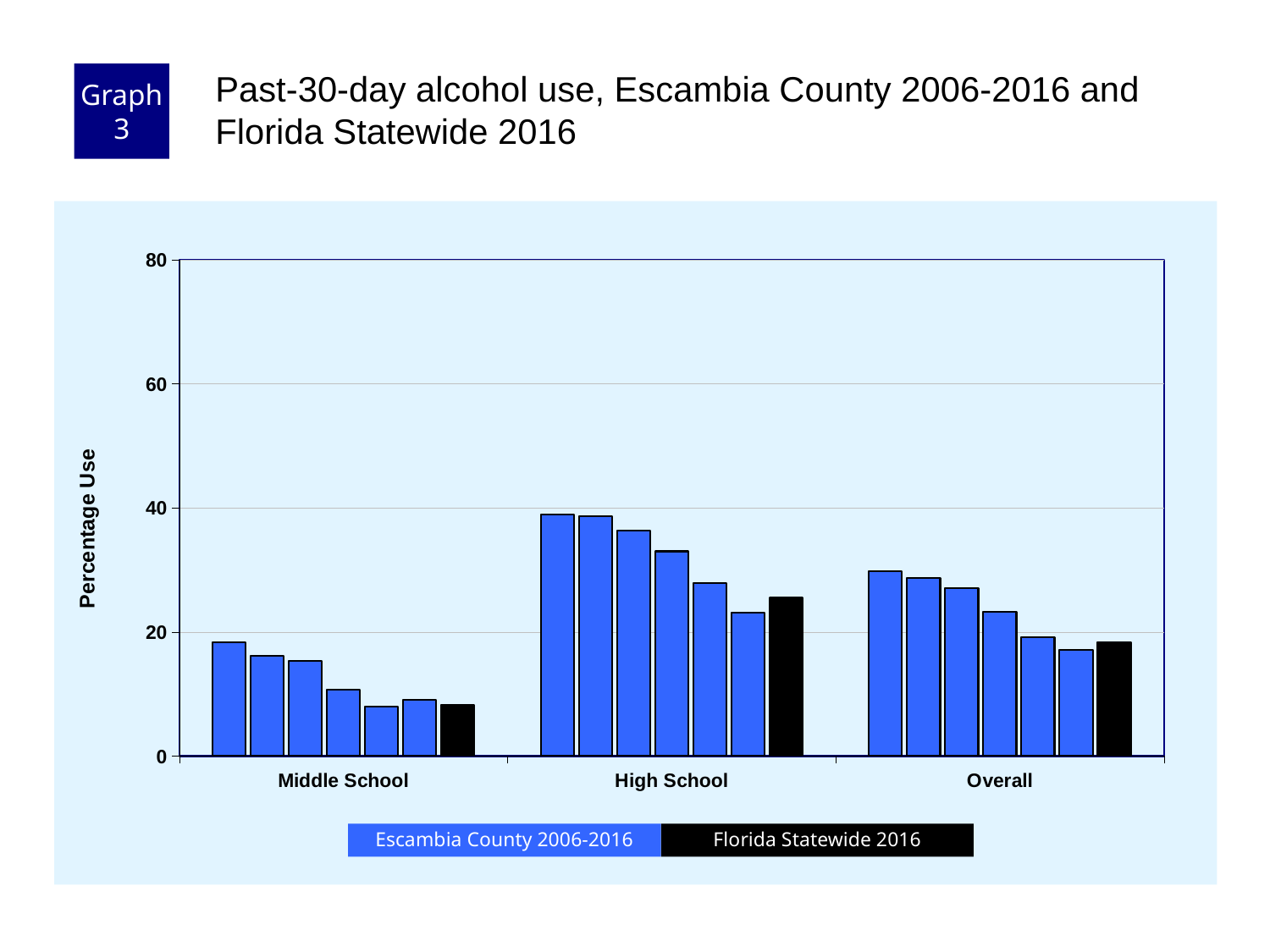
Which category has the highest percentage use values? High School How many series does the legend list? 2 What is the label on the y axis? Percentage Use What kind of chart is shown on the slide? bar chart Is the tallest Escambia County bar for High School greater or less than 20? greater Within the High School group, do the Escambia County 2006-2016 bars rise or fall from left to right? fall Which is larger, the Florida Statewide 2016 value for High School or for Middle School? High School How many school-level categories are shown on the x axis? 3 Is the Florida Statewide 2016 value for Middle School greater or less than 20? less Which category has the lowest percentage use values? Middle School Is the tallest Escambia County bar for Overall greater or less than 40? less